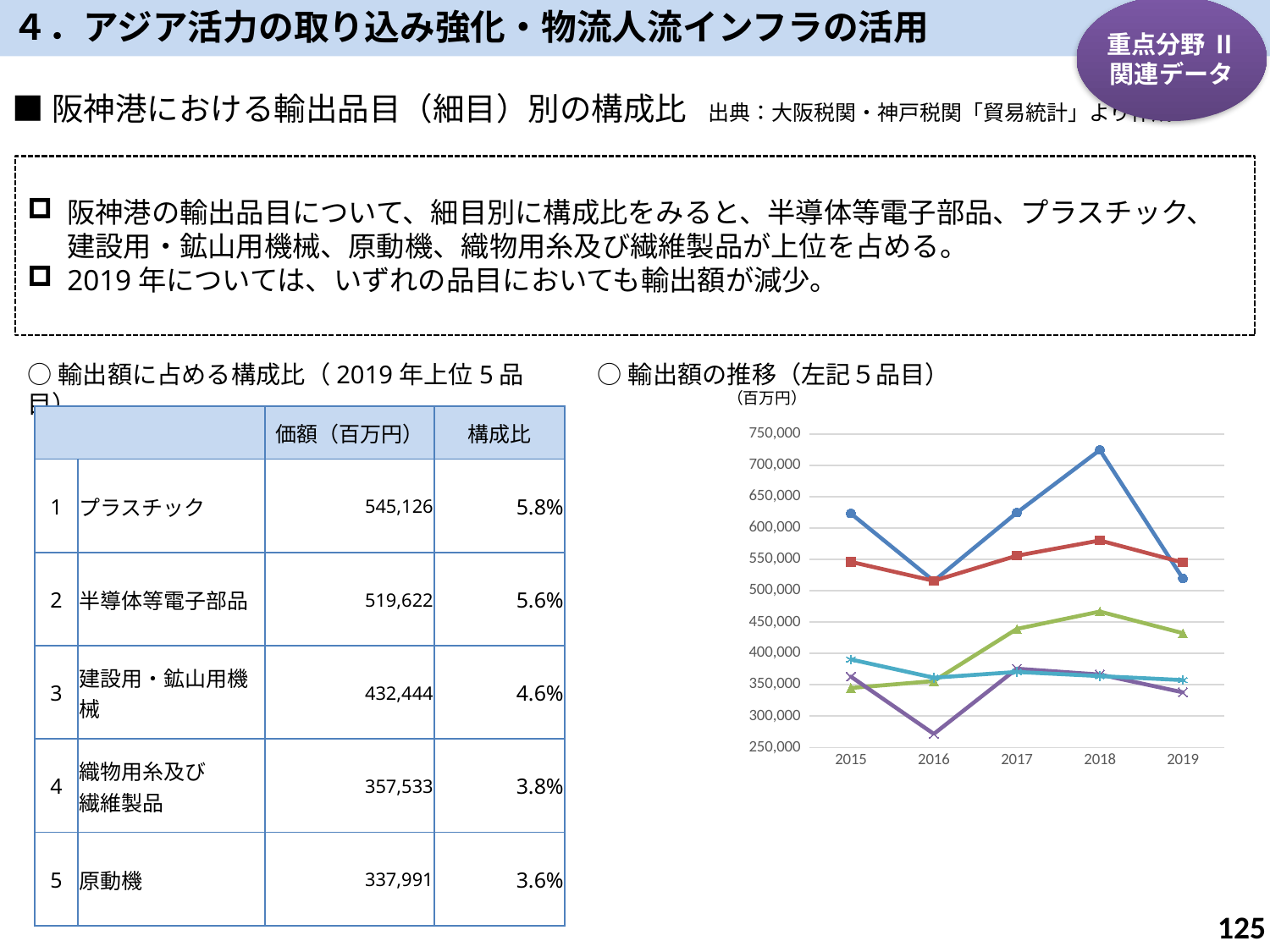
How many years are plotted along the x axis of the line chart? 5 In the line chart, does the blue line rise or fall from 2018 to 2019? fall In the line chart, in which year does the blue line reach its highest value? 2018 In the line chart, in which year does the purple line reach its lowest value? 2016 What unit is shown above the y axis of the line chart? 百万円 In the line chart, is the value of the blue line in 2018 greater or less than 700,000? greater In the line chart, is the value of the red line in 2018 greater or less than 550,000? greater In the line chart, is the value of the blue line in 2016 greater or less than 550,000? less In the line chart, which is larger in 2015, the blue line or the red line? the blue line How many lines are plotted in the line chart? 5 What kind of chart is shown under the title 輸出額の推移（左記５品目）? line chart